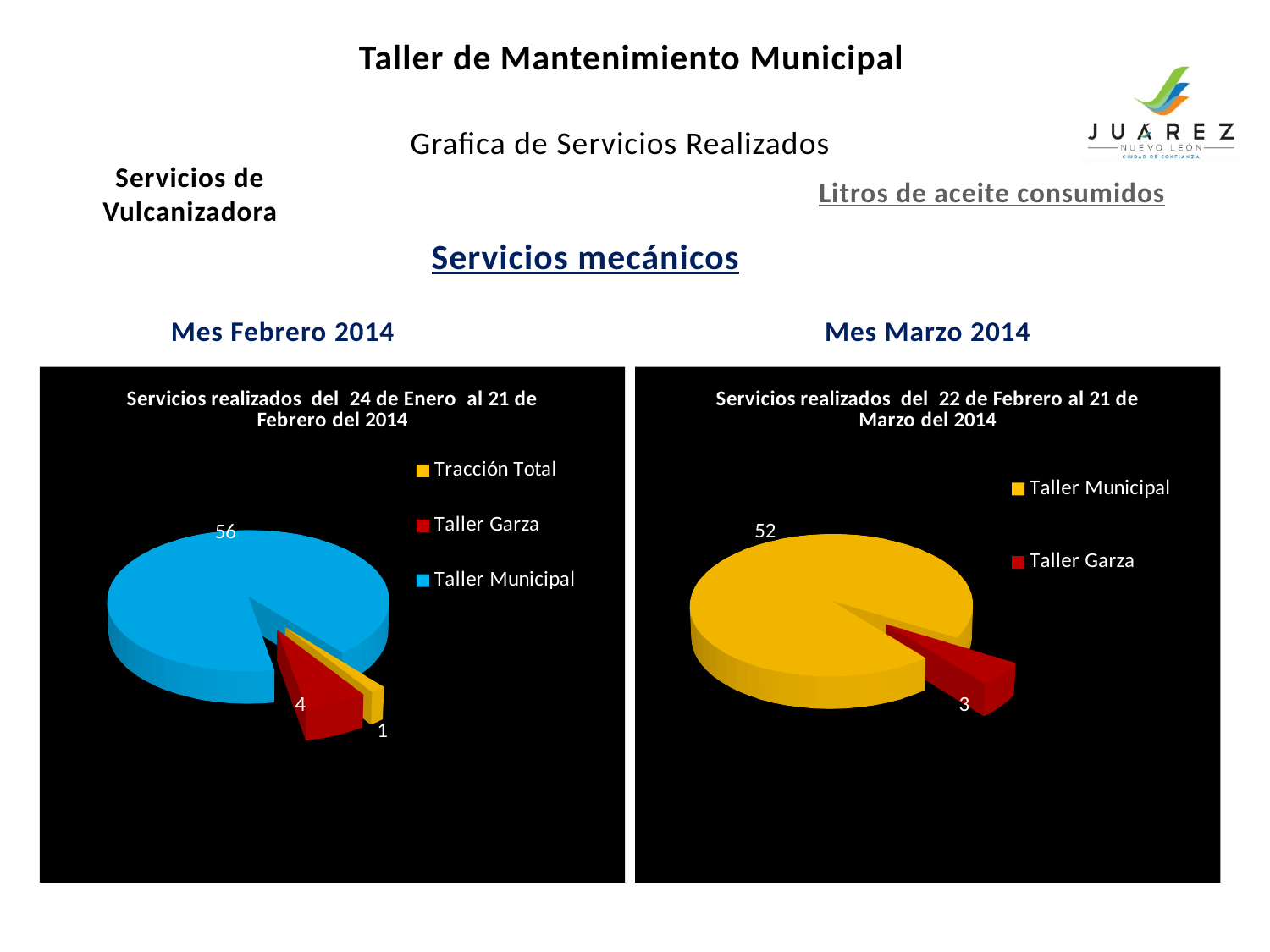
In the Mes Marzo 2014 chart, what is the value for Taller Garza? 3 In the Mes Febrero 2014 chart, what is the value for Tracción Total? 1 In the Mes Febrero 2014 chart, what is the value for Taller Municipal? 56 In the Mes Febrero 2014 chart, which category has the largest slice? Taller Municipal How many categories does the legend of the Mes Marzo 2014 chart list? 2 What kind of chart is the Mes Marzo 2014 chart? Pie chart In the Mes Marzo 2014 chart, what is the value for Taller Municipal? 52 In the Mes Febrero 2014 chart, what is the difference between Taller Municipal and Taller Garza? 52 In the Mes Febrero 2014 chart, what is the value for Taller Garza? 4 In the Mes Febrero 2014 chart, which category has the smallest slice? Tracción Total In the Mes Marzo 2014 chart, what is the difference between Taller Municipal and Taller Garza? 49 How many categories does the legend of the Mes Febrero 2014 chart list? 3